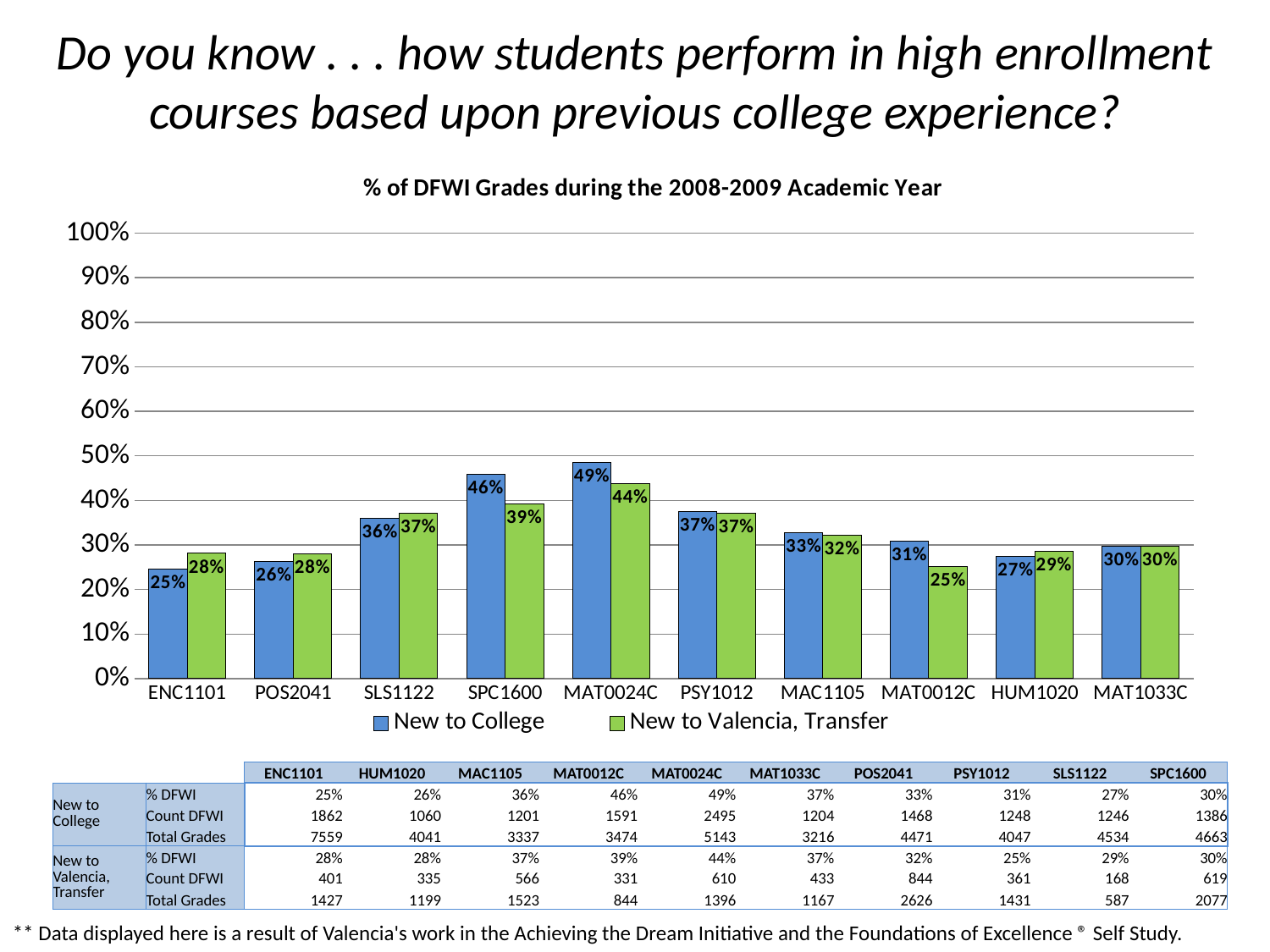
What is the % of DFWI grades for New to College students in SPC1600? 46% What kind of chart is shown on the slide? Bar chart Which course has the lowest % of DFWI grades for New to College students? ENC1101 Which course has the lowest % of DFWI grades for New to Valencia, Transfer students? MAT0012C What is the title of the chart? % of DFWI Grades during the 2008-2009 Academic Year In MAT0012C, which group has the higher % of DFWI grades: New to College or New to Valencia, Transfer? New to College What is the % of DFWI grades for New to Valencia, Transfer students in MAT0012C? 25% In SPC1600, how many percentage points higher is the New to College DFWI rate than the New to Valencia, Transfer rate? 7 percentage points How many courses are shown on the x axis of the chart? 10 What is the % of DFWI grades for New to College students in ENC1101? 25% How many series does the chart legend list? 2 Which course has the highest % of DFWI grades for New to College students? MAT0024C